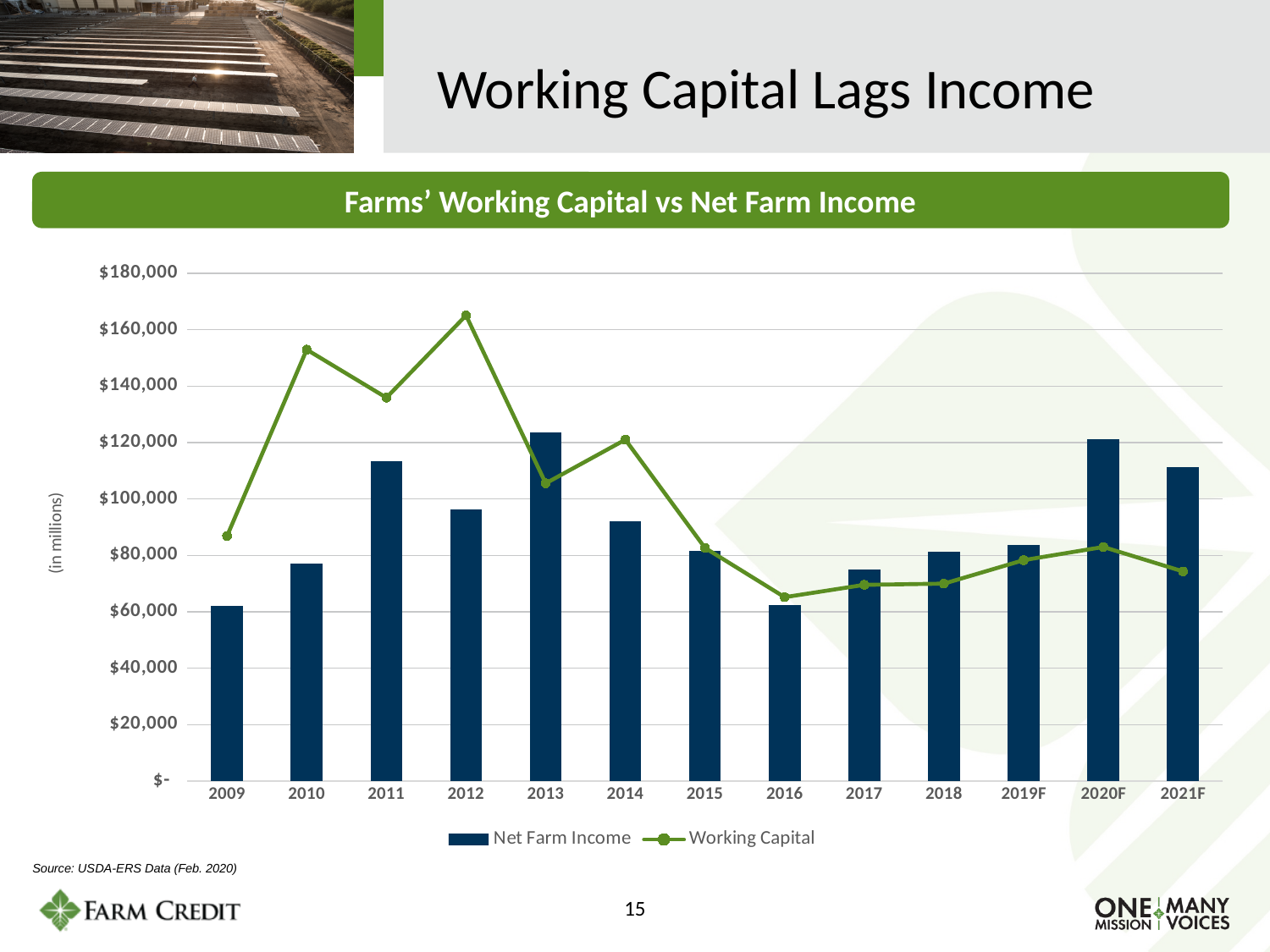
Is the Net Farm Income value for 2009 greater or less than $80,000? less Is the Working Capital value for 2021F greater or less than $80,000? less What kind of chart is shown on the slide? A combined bar and line chart How many years are shown on the x axis? 13 In which year is Working Capital lowest? 2016 Is the Net Farm Income value for 2011 greater or less than $100,000? greater How many series does the legend list? 2 In 2011, which is larger: Net Farm Income or Working Capital? Working Capital In 2020F, which is larger: Net Farm Income or Working Capital? Net Farm Income In which year is Working Capital highest? 2012 Does Working Capital rise or fall from 2012 to 2016? Fall